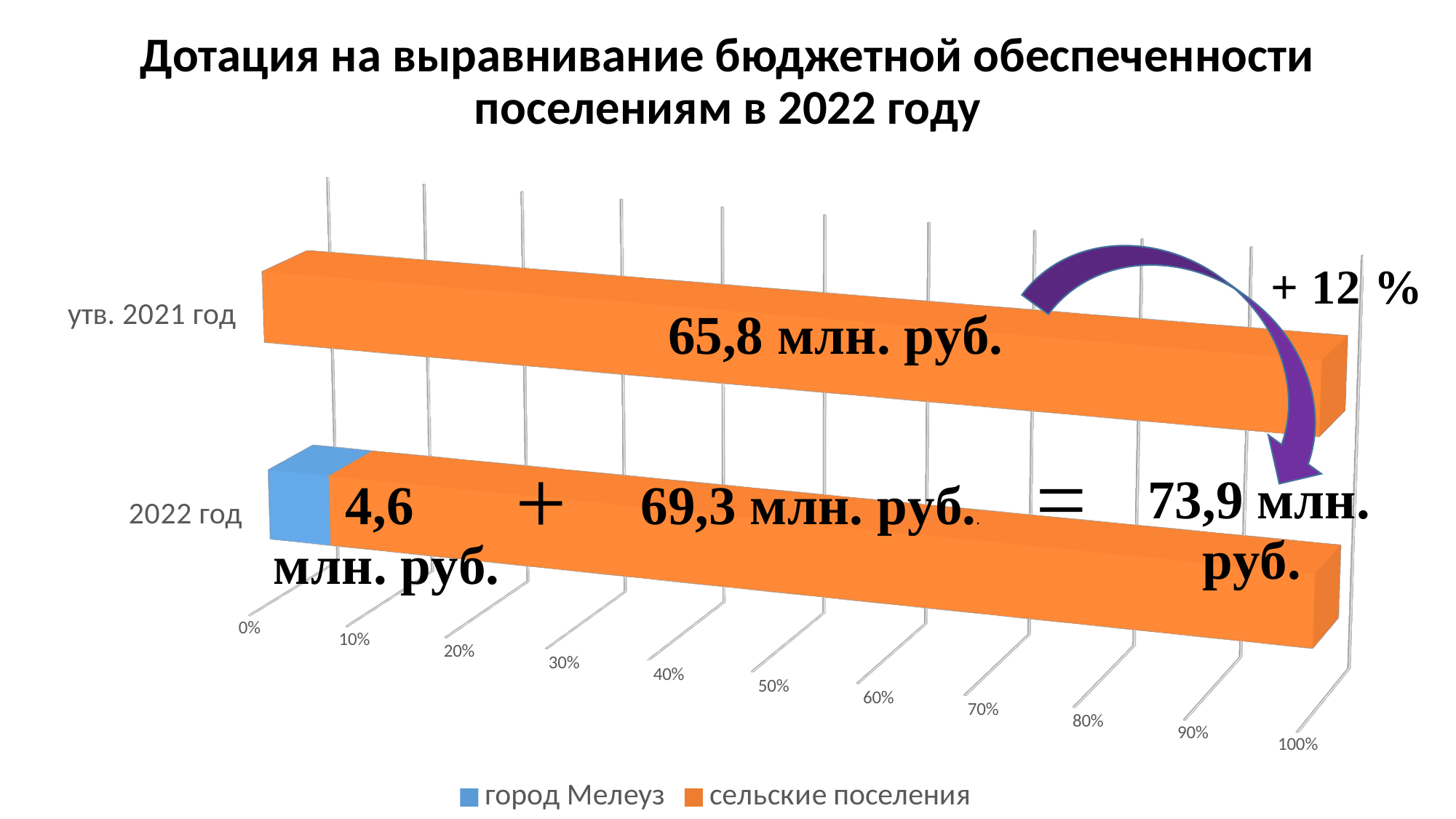
How many series does the legend list? 2 Which series is shown in blue in the legend? город Мелеуз How many categories (years) are plotted on the chart? 2 Which category has the higher total value? 2022 год What is the value for город Мелеуз in 2022 год? 4,6 млн. руб. By what percentage did the total change from утв. 2021 год to 2022 год, according to the annotation? + 12 % What is the difference between the сельские поселения values for 2022 год and утв. 2021 год? 3,5 млн. руб. What is the value for сельские поселения in 2022 год? 69,3 млн. руб. What is the value shown for утв. 2021 год? 65,8 млн. руб. What kind of chart is shown on the slide? bar chart What is the total of the stacked bar for 2022 год? 73,9 млн. руб. Which is larger in 2022 год: the value for город Мелеуз or for сельские поселения? сельские поселения